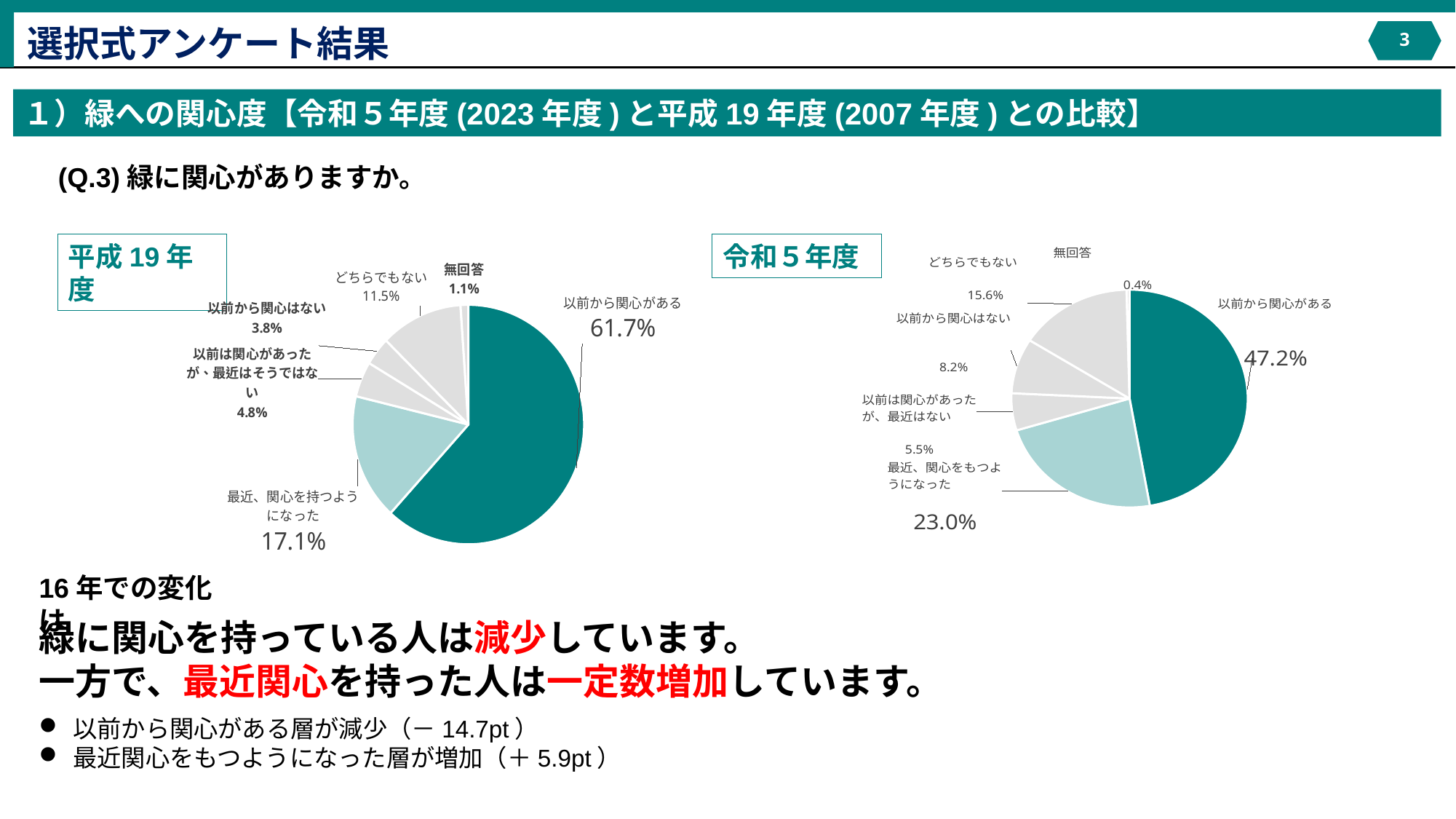
In the 令和5年度 pie chart, what percentage is shown for 無回答? 0.4% In the 平成19年度 pie chart, which category has the largest share? 以前から関心がある How many slices does the 平成19年度 pie chart have? 6 In the 令和5年度 pie chart, which category has the smallest share? 無回答 In the 平成19年度 pie chart, what percentage is shown for どちらでもない? 11.5% In the 令和5年度 pie chart, what percentage is shown for 最近、関心をもつようになった? 23.0% In the 令和5年度 pie chart, which is larger: 以前から関心はない or 以前は関心があったが、最近はない? 以前から関心はない In the 平成19年度 pie chart, what is the combined share of 以前から関心がある (61.7%) and 最近、関心を持つようになった (17.1%)? 78.8% What is the difference between the 以前から関心がある share in the 平成19年度 chart (61.7%) and in the 令和5年度 chart (47.2%)? 14.5% In the 令和5年度 pie chart, what percentage is shown for 以前から関心がある? 47.2% What type of chart is used for the 令和5年度 data? Pie chart In the 平成19年度 pie chart, what percentage is shown for 以前から関心がある? 61.7%